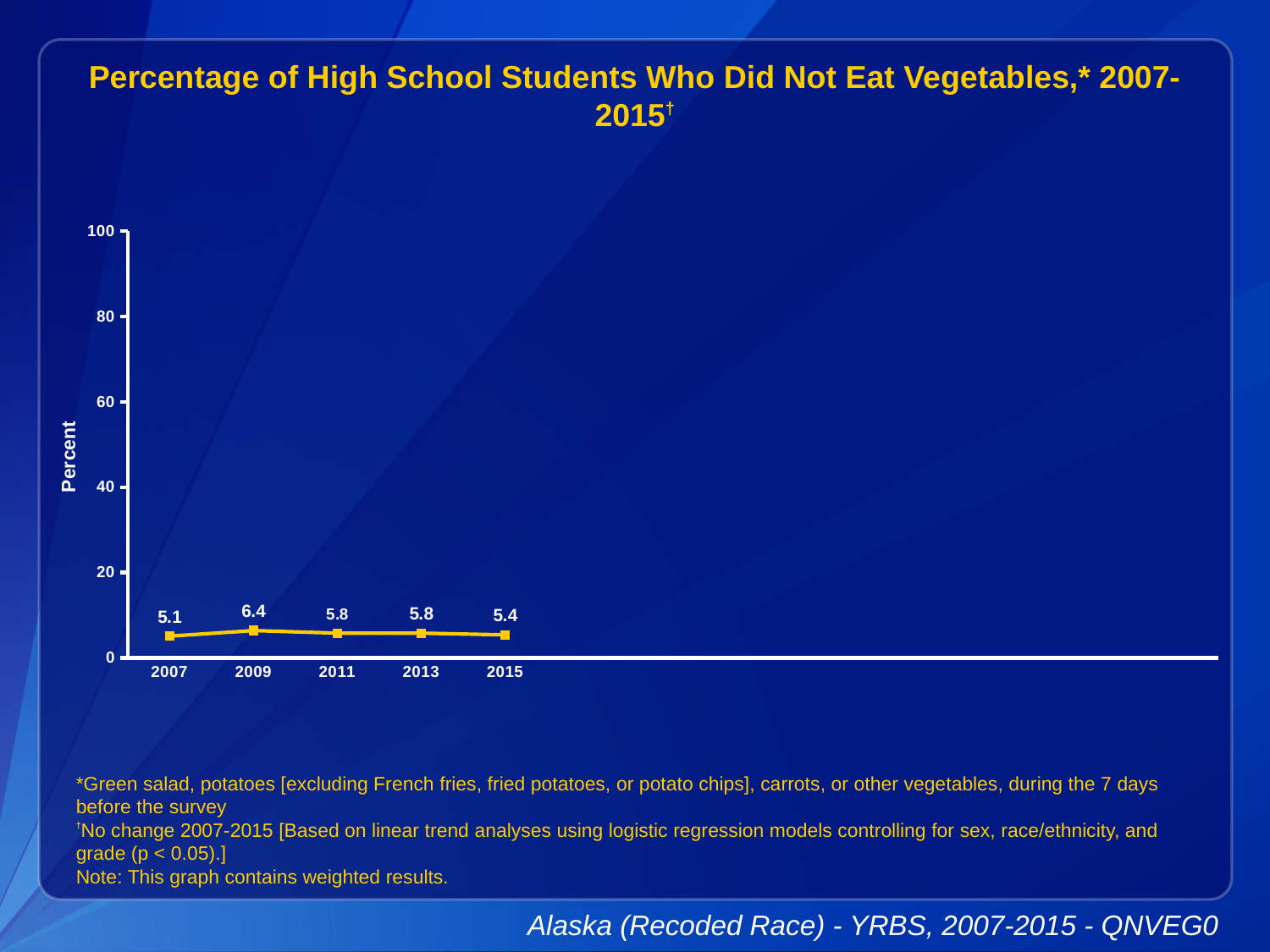
How many years are plotted on the chart? 5 Which year has the lowest value? 2007 Is the value for 2011 greater or less than 20? less What is the maximum value shown on the y axis? 100 What is the difference between the values for 2009 and 2007? 1.3 What is the value for 2007? 5.1 What is the label on the y axis? Percent What is the value for 2015? 5.4 What kind of chart is shown? line chart Which is larger, the value for 2009 or the value for 2015? 2009 What is the value for 2009? 6.4 Which year has the highest value? 2009